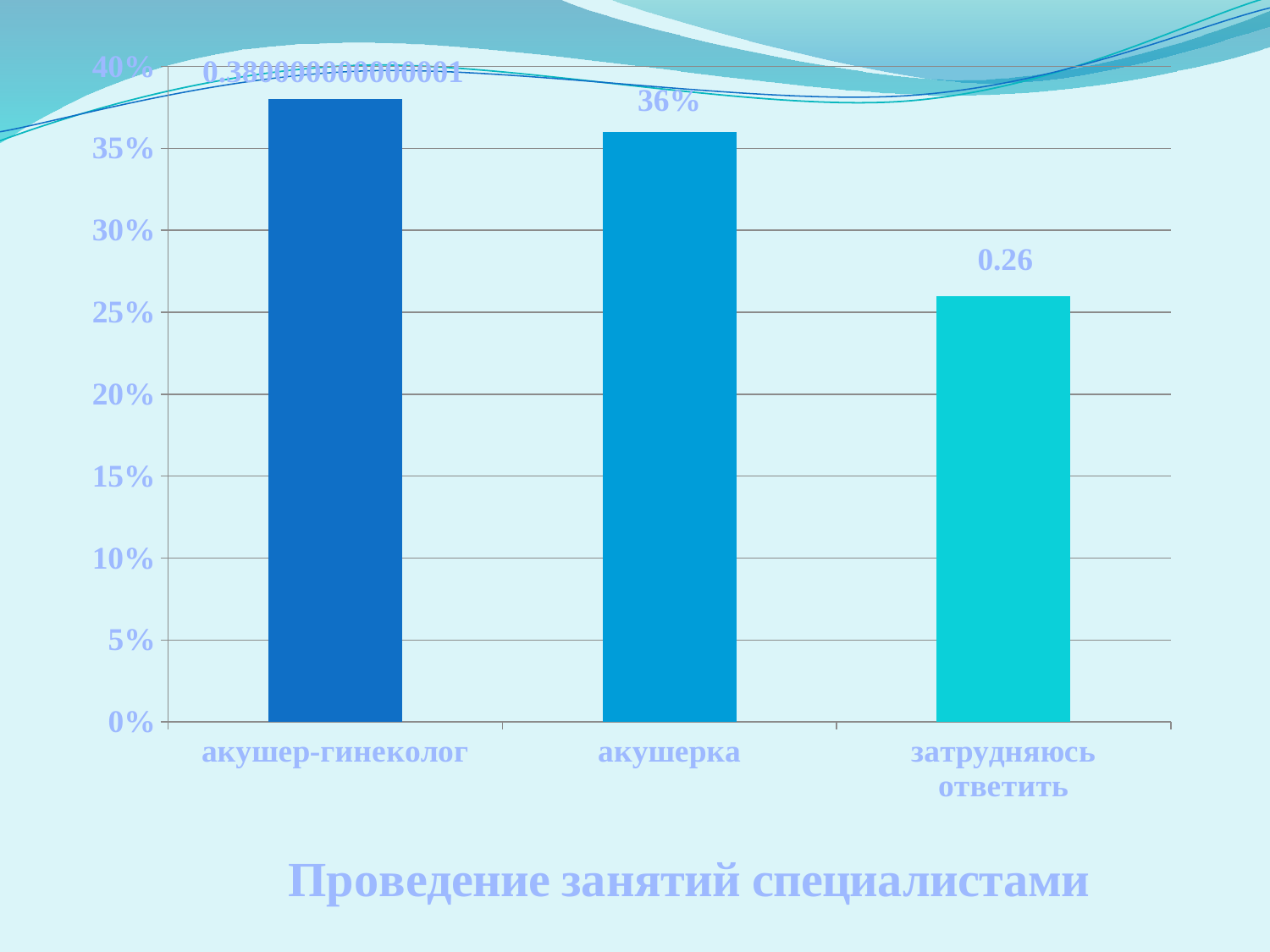
Which category has the lowest bar? затрудняюсь ответить Do the bar values rise or fall from left to right along the x axis? fall How many categories are shown on the x axis? 3 What is the value shown for акушерка? 36% Which is larger, the value for акушерка or the value for затрудняюсь ответить? акушерка What data label is shown above the bar for затрудняюсь ответить? 0.26 Is the value for затрудняюсь ответить greater or less than 30%? less What is the highest tick value shown on the vertical axis? 40% What kind of chart is shown on the slide? bar chart Is the value for акушер-гинеколог greater or less than 35%? greater Which category has the highest bar? акушер-гинеколог What is the title shown below the chart? Проведение занятий специалистами